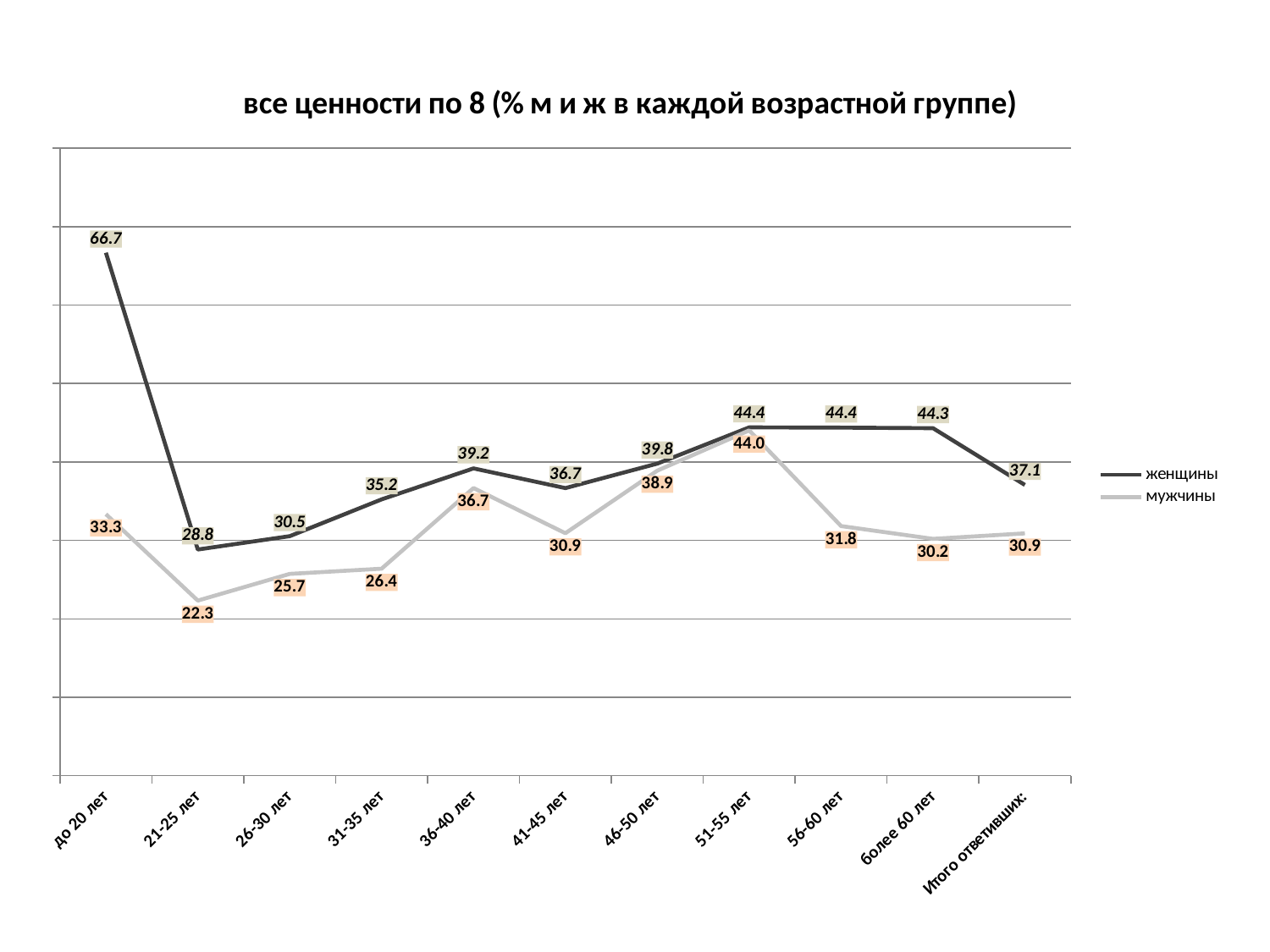
What is the value for женщины in the до 20 лет group? 66.7 What kind of chart is shown on the slide? line chart How many series does the legend list? 2 What is the difference between the женщины and мужчины values in the 41-45 лет group? 5.8 In which age group is the value for женщины the highest? до 20 лет In which age group is the value for мужчины the lowest? 21-25 лет In which age group is the value for мужчины the highest? 51-55 лет In the 56-60 лет group, which series has the larger value, женщины or мужчины? женщины By how much does the женщины value drop from до 20 лет to 21-25 лет? 37.9 How many categories are shown on the x axis? 11 What is the value for мужчины in the Итого ответивших: category? 30.9 What is the value for мужчины in the 21-25 лет group? 22.3